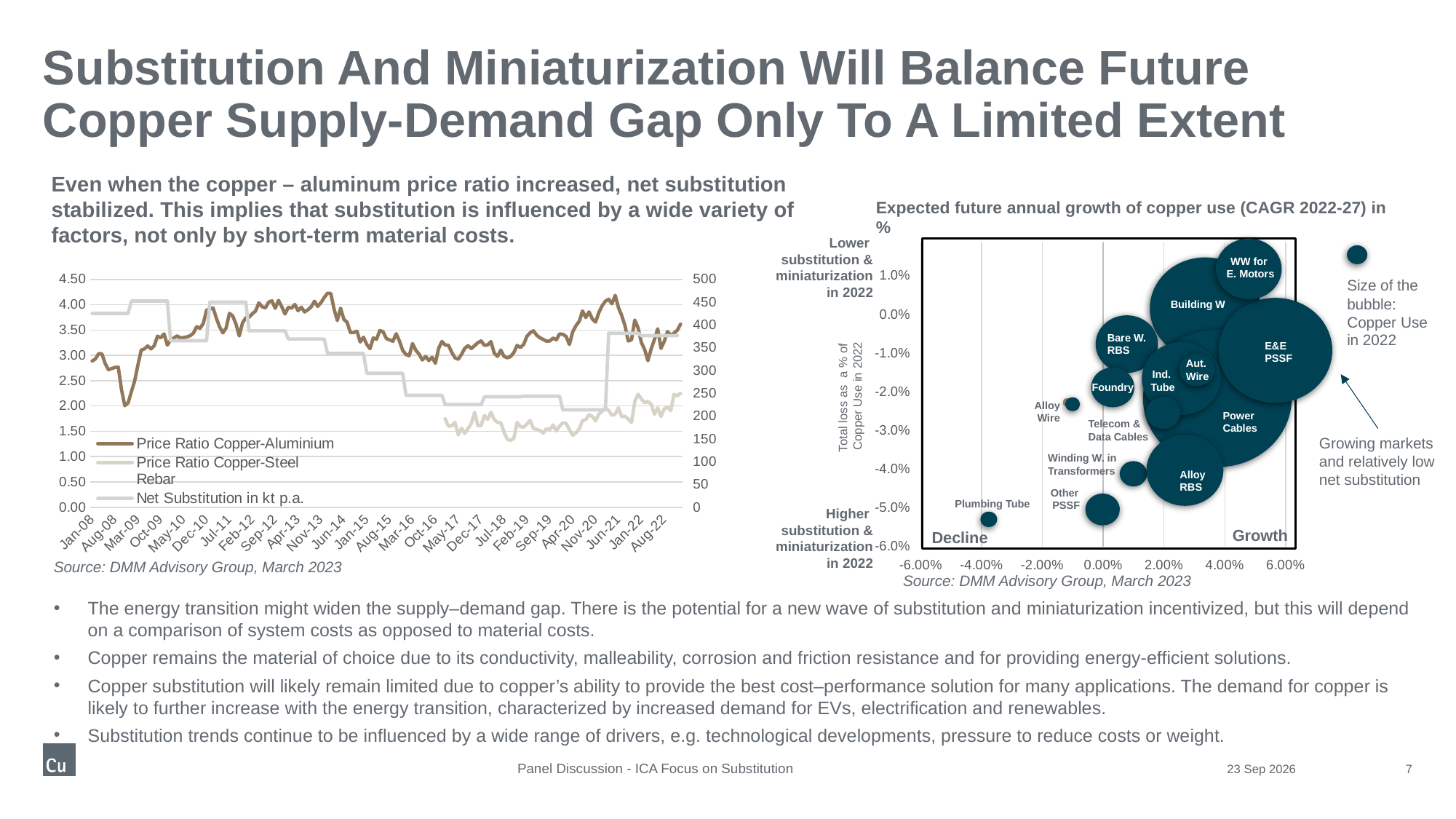
In the left chart, is the Net Substitution in kt p.a. at Jun-21 greater or less than 300? greater In the right bubble chart, is the horizontal-axis value for E&E PSSF greater or less than 2.00%? greater What are the three series named in the legend of the left chart? Price Ratio Copper-Aluminium, Price Ratio Copper-Steel Rebar, Net Substitution in kt p.a. How many series does the legend of the left chart list? 3 In the left chart, is the Price Ratio Copper-Aluminium at Jan-08 greater or less than 2.50? greater What kind of chart is the right chart titled 'Expected future annual growth of copper use (CAGR 2022-27) in %'? Bubble chart How many labelled bubbles are plotted in the right bubble chart? 14 In the right bubble chart, which application has the largest bubble? E&E PSSF In the left chart, at Aug-22, which is larger: the Price Ratio Copper-Aluminium or the Price Ratio Copper-Steel Rebar? Price Ratio Copper-Aluminium What kind of chart is the left chart showing price ratios and net substitution? Line chart